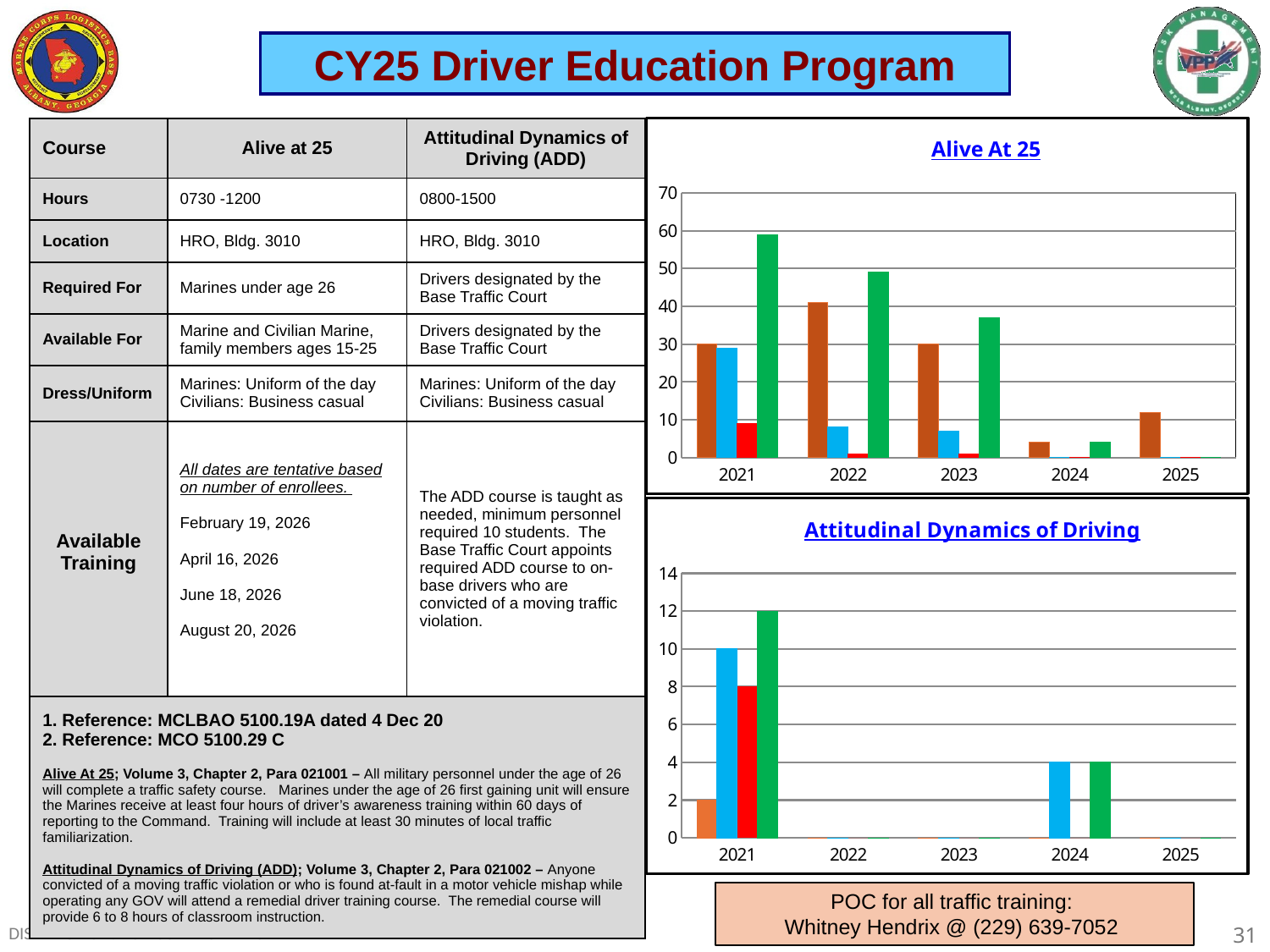
In the 'Alive At 25' chart, which year has the tallest bar? 2021 What kind of chart is the 'Attitudinal Dynamics of Driving' chart? bar chart How many years are shown on the x axis of the 'Alive At 25' chart? 5 In the 'Alive At 25' chart, is the tallest bar for 2024 greater or less than 10? less In the 'Attitudinal Dynamics of Driving' chart, what value does the green bar for 2021 reach? 12 In the 'Attitudinal Dynamics of Driving' chart, which year has the tallest bar? 2021 In the 'Attitudinal Dynamics of Driving' chart, what value does the blue bar for 2024 reach? 4 In the 'Alive At 25' chart, is the tallest bar for 2021 greater or less than 50? greater In the 'Alive At 25' chart, is the tallest bar for 2023 greater or less than 30? greater What kind of chart is the 'Alive At 25' chart? bar chart In the 'Attitudinal Dynamics of Driving' chart, is the green bar for 2021 or the green bar for 2024 larger? 2021 What is the highest value shown on the y axis of the 'Alive At 25' chart? 70